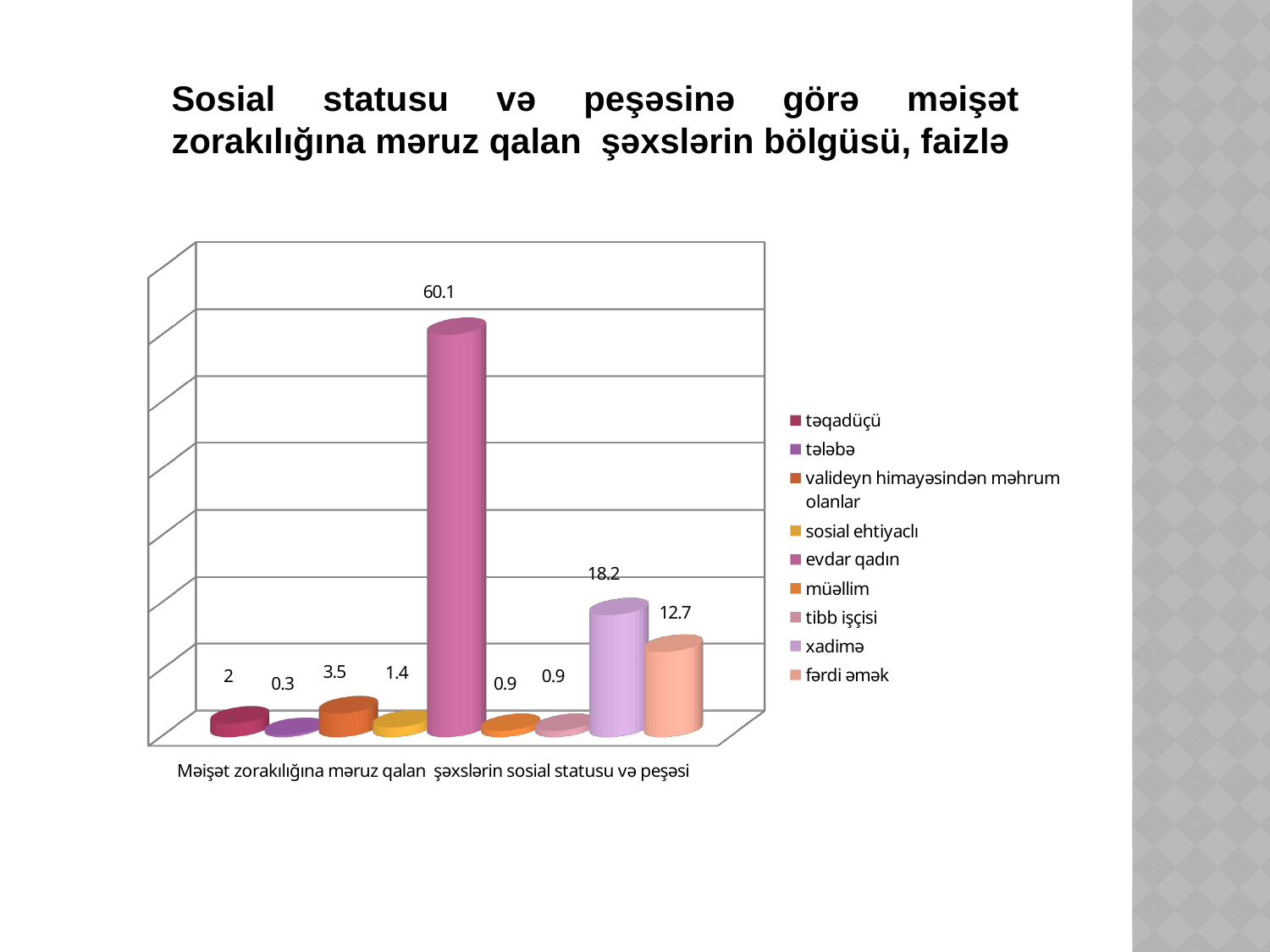
What is the difference between the values for xadimə and fərdi əmək? 5.5 What type of chart is shown on the slide? bar chart What is the x-axis title of the chart? Məişət zorakılığına məruz qalan şəxslərin sosial statusu və peşəsi What is the value for fərdi əmək? 12.7 How many entries does the legend list? 9 Which category has the highest value? evdar qadın What is the value for xadimə? 18.2 What is the value for tələbə? 0.3 What is the value for evdar qadın? 60.1 What is the value for valideyn himayəsindən məhrum olanlar? 3.5 Which category has the lowest value? tələbə Which is larger, the value for təqadüçü or the value for sosial ehtiyaclı? təqadüçü